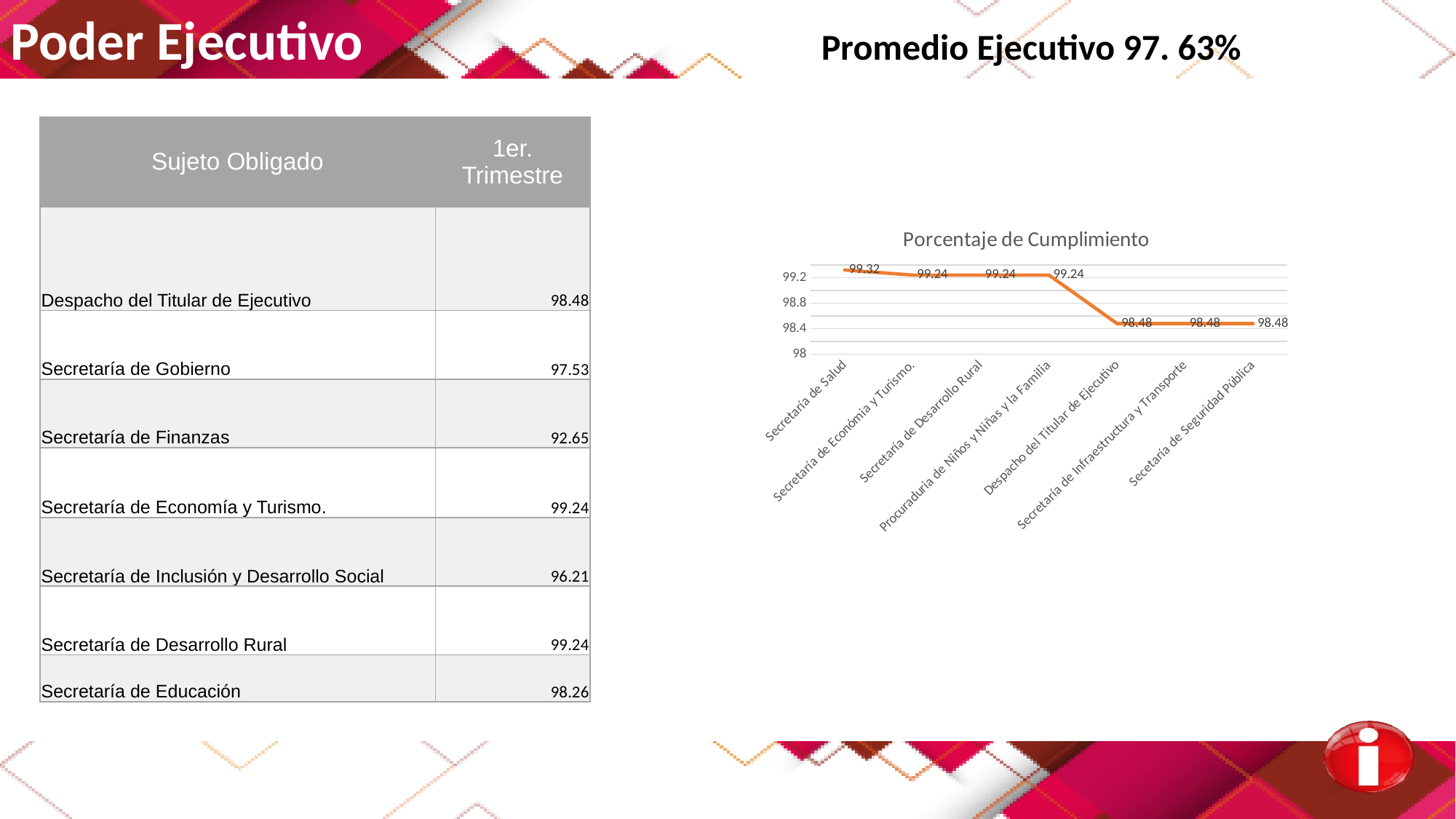
What kind of chart is shown on the slide? line chart Is the value for Secretaría de Economía y Turismo greater or less than 98.8? greater What is the value for Secretaría de Desarrollo Rural on the chart? 99.24 How many categories are plotted on the chart? 7 What is the difference between the values for Secretaría de Salud and Secretaría de Economía y Turismo? 0.08 What is the value for Despacho del Titular de Ejecutivo on the chart? 98.48 What is the value for Secretaría de Salud on the chart? 99.32 Do the values on the chart generally rise or fall from left to right? fall Which category has the highest value on the chart? Secretaría de Salud What is the difference between the values for Secretaría de Salud and Secretaría de Infraestructura y Transporte? 0.84 Which is larger on the chart: the value for Procuraduría de Niños y Niñas y la Familia or the value for Secetaría de Seguridad Pública? Procuraduría de Niños y Niñas y la Familia What is the title of the chart? Porcentaje de Cumplimiento